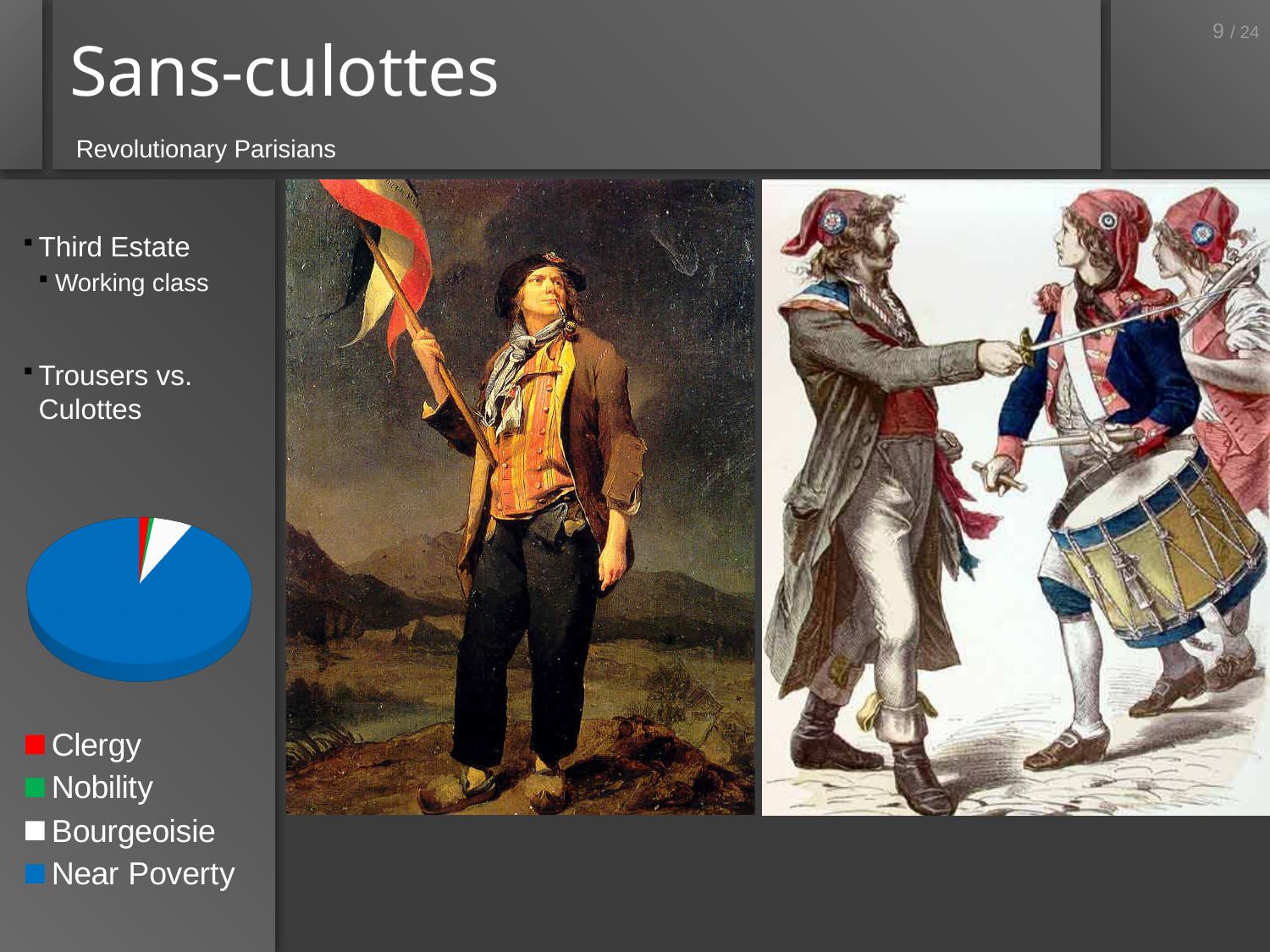
Which slice is larger in the pie chart, Near Poverty or Bourgeoisie? Near Poverty What colour is the Near Poverty slice in the pie chart? blue How many categories does the pie chart's legend list? 4 Which category has the largest slice of the pie chart? Near Poverty Which category in the pie chart's legend is shown in red? Clergy What kind of chart is shown on the slide? pie chart Which slice is larger in the pie chart, Bourgeoisie or Clergy? Bourgeoisie Which slice is larger in the pie chart, Bourgeoisie or Nobility? Bourgeoisie